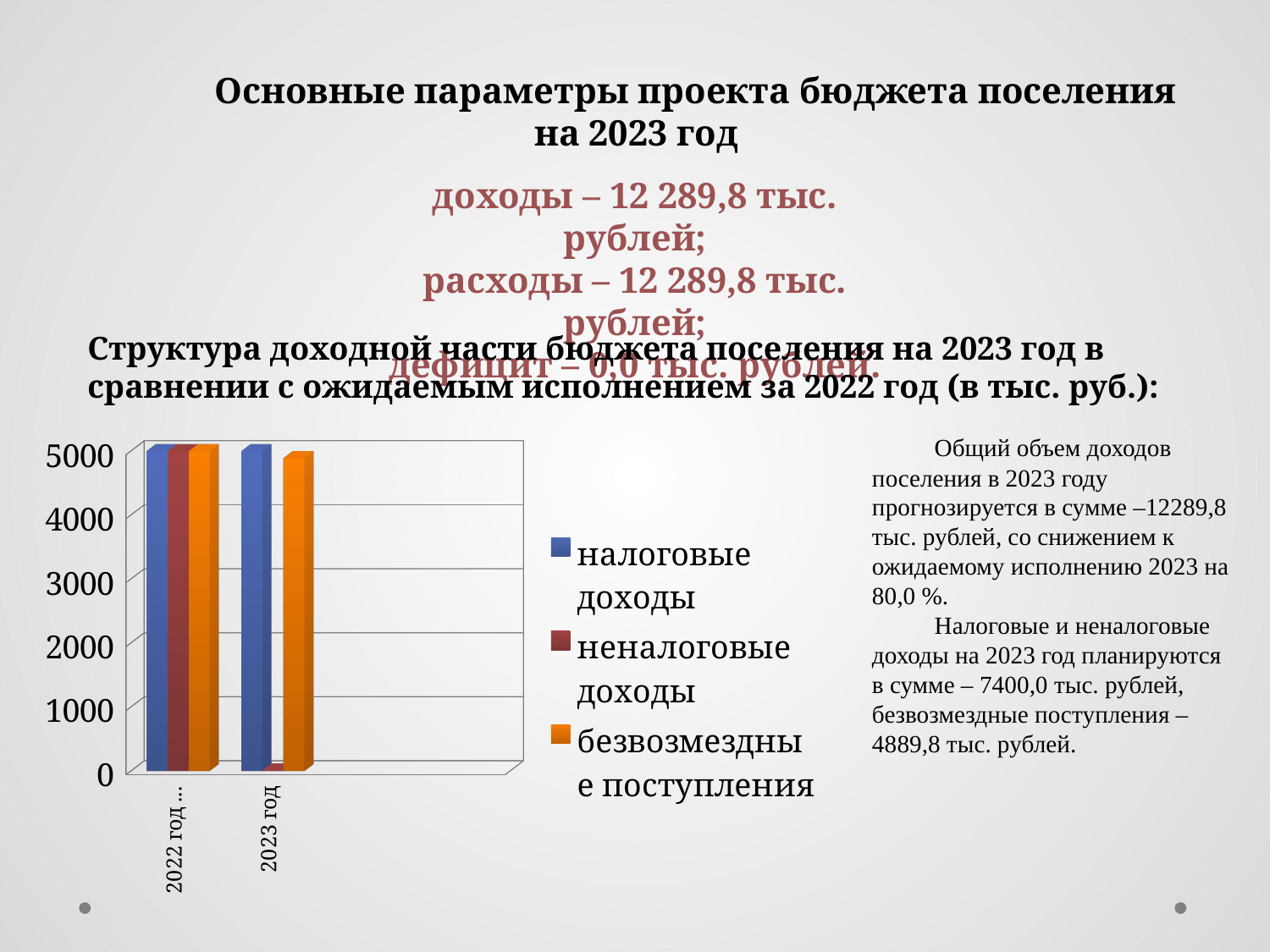
How many categories (years) are shown on the x axis of the chart? 2 For 2023 год, which is larger: налоговые доходы or неналоговые доходы? налоговые доходы Which series is shown in orange in the chart legend? безвозмездные поступления How many series does the chart legend list? 3 Is the value of безвозмездные поступления for 2023 год greater or less than 4000? greater Is the value of налоговые доходы for 2023 год greater or less than 3000? greater Is the value of неналоговые доходы for 2023 год greater or less than 1000? less What kind of chart is shown on the slide? bar chart Does the value of неналоговые доходы rise or fall from the 2022 category to 2023 год? fall What is the first series listed in the chart legend? налоговые доходы Which series has the lowest value for 2023 год? неналоговые доходы